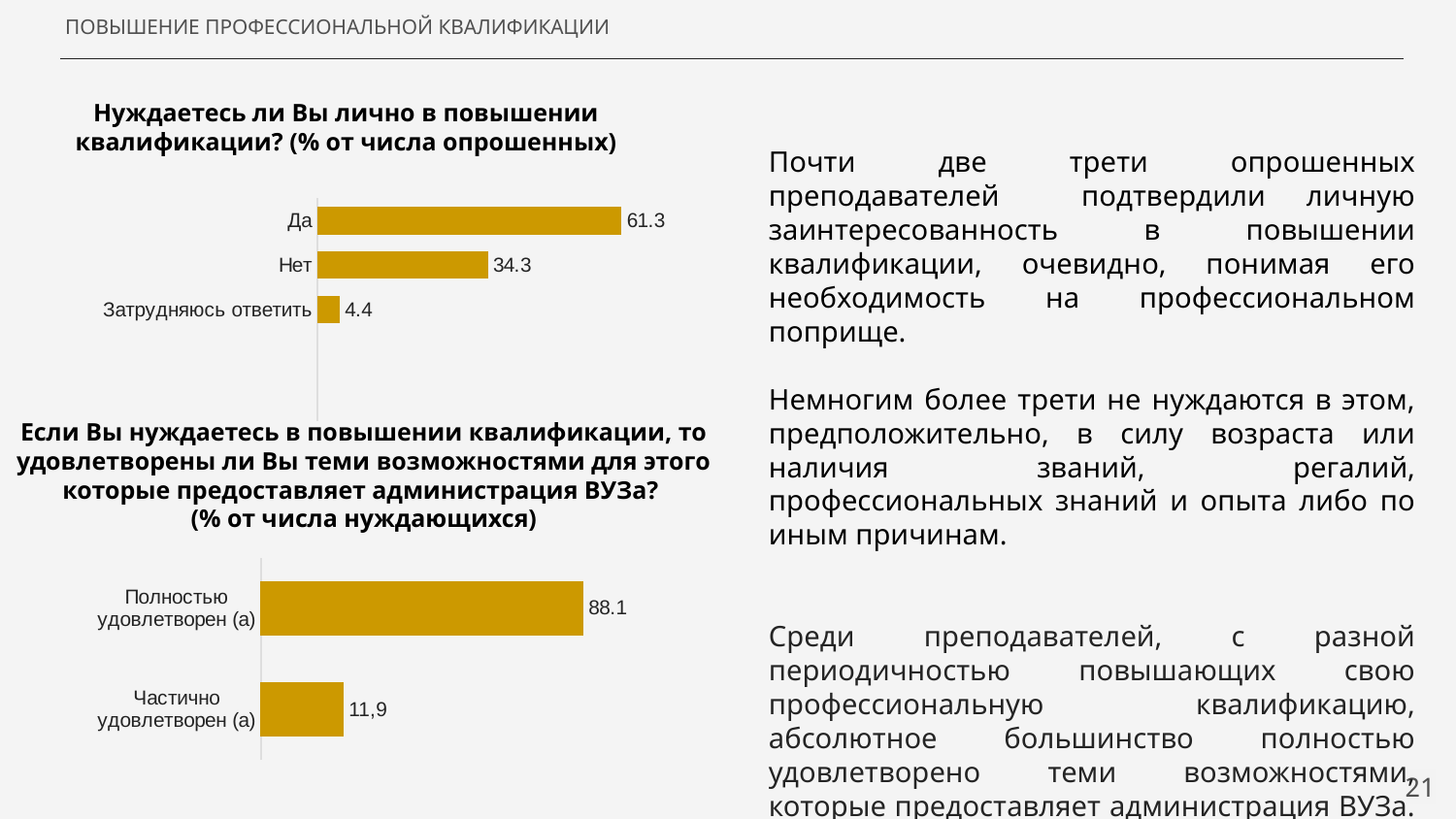
What colour are the bars in the top chart? Gold (dark yellow) In the bottom chart ("Если Вы нуждаетесь в повышении квалификации..."), what is the value for "Полностью удовлетворен (а)"? 88.1 In the top chart, which category has the lowest value? Затрудняюсь ответить In the top chart, what is the value for "Нет"? 34.3 In the top chart, what is the value for "Затрудняюсь ответить"? 4.4 In the bottom chart, which is larger: "Полностью удовлетворен (а)" or "Частично удовлетворен (а)"? Полностью удовлетворен (а) In the top chart, how many categories are shown? 3 In the top chart, which category has the highest value? Да In the top chart, what is the difference between the values for "Да" and "Нет"? 27.0 In the top chart ("Нуждаетесь ли Вы лично в повышении квалификации?"), what is the value for "Да"? 61.3 In the bottom chart, what is the value for "Частично удовлетворен (а)"? 11,9 What type of chart is the bottom chart? Bar chart